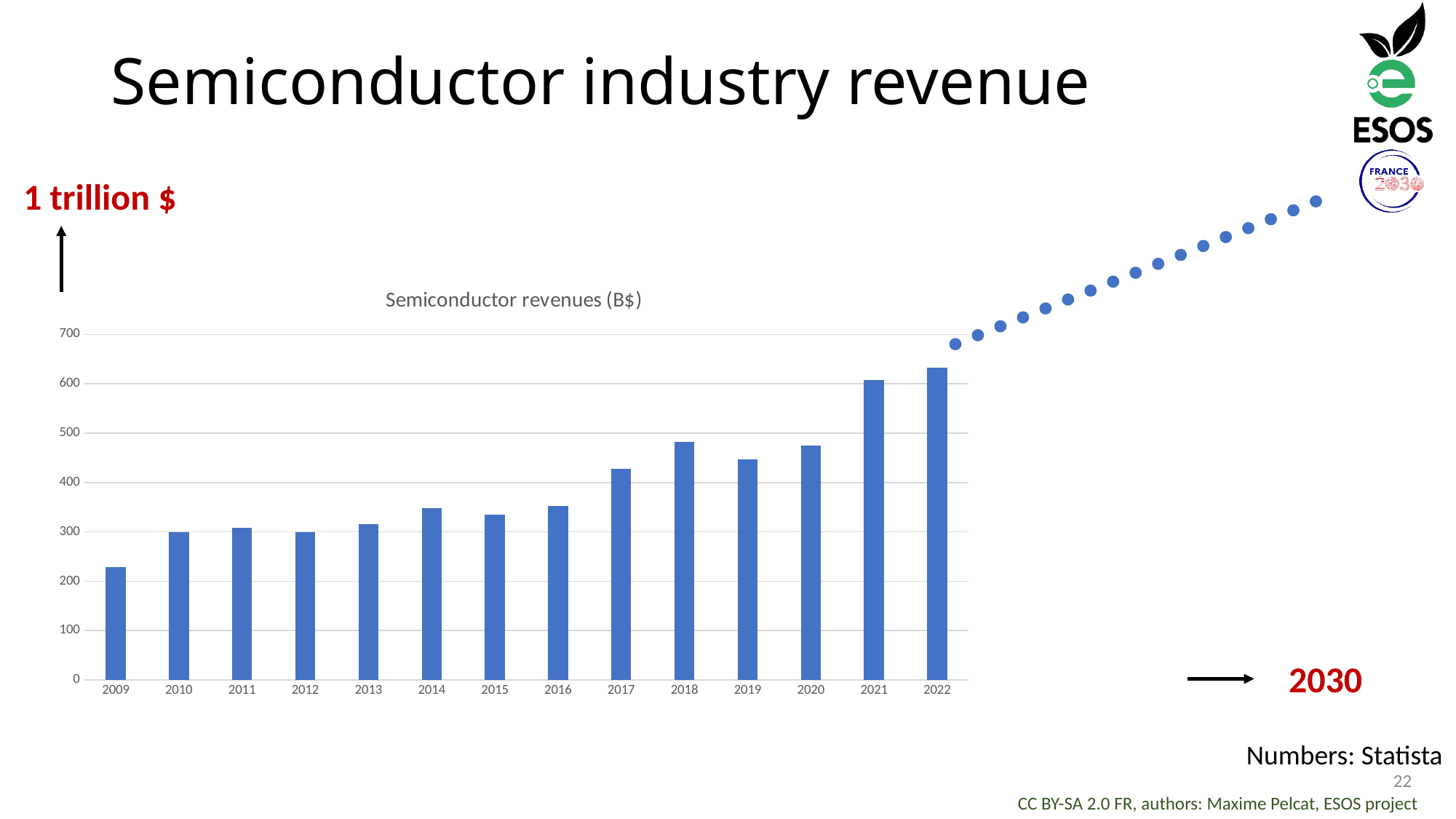
Do semiconductor revenues generally rise or fall from 2009 to 2022? rise How many years are plotted as bars in the chart? 14 Is the value for 2022 greater or less than 600? greater Which year has the larger revenue, 2018 or 2019? 2018 Which year has the larger revenue, 2020 or 2019? 2020 What kind of chart is shown on the slide? bar chart Which year has the highest semiconductor revenue in the chart? 2022 Is the value for 2009 greater or less than 300? less Is the value for 2017 greater or less than 400? greater Which year has the lowest semiconductor revenue in the chart? 2009 What is the title of the chart? Semiconductor revenues (B$)